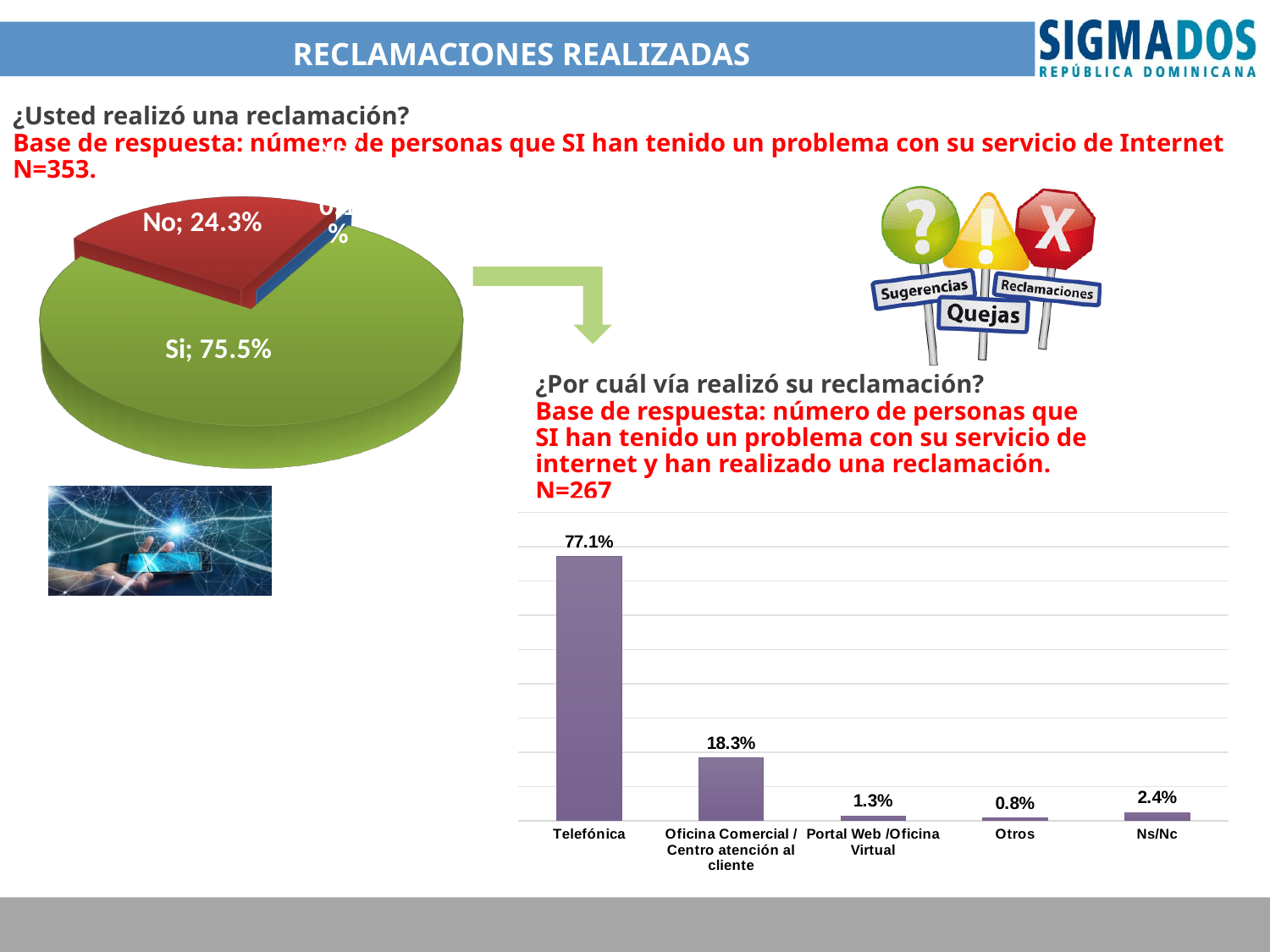
How many categories are shown in the bar chart on the right? 5 In the bar chart on the right, what is the difference between Telefónica and Oficina Comercial / Centro atención al cliente? 58.8% In the bar chart on the right, what is the value for Ns/Nc? 2.4% In the bar chart on the right, what is the value for Oficina Comercial / Centro atención al cliente? 18.3% In the pie chart on the left, which answer has the larger share, 'Si' or 'No'? Si What kind of chart is the chart on the left of the slide? Pie chart In the pie chart on the left, what is the difference between the 'Si' and 'No' shares? 51.2% In the bar chart on the right, which category has the highest value? Telefónica In the bar chart on the right, what is the value for Telefónica? 77.1% In the pie chart on the left, what percentage of respondents answered 'Si'? 75.5% In the pie chart on the left, what percentage of respondents answered 'No'? 24.3% In the bar chart on the right, which category has the lowest value? Otros